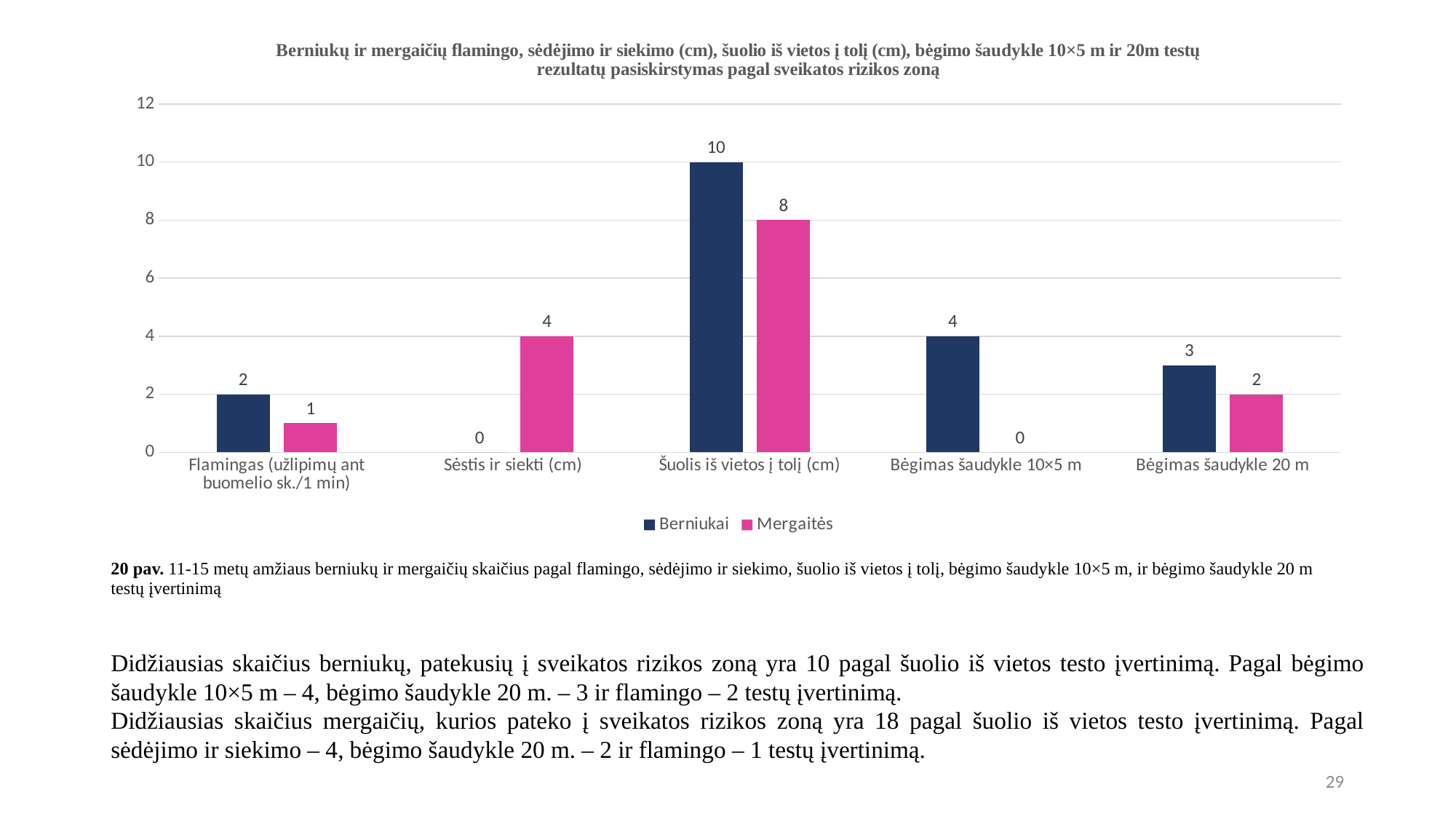
What kind of chart is shown on the slide? Bar chart Which category has the highest value for Mergaitės? Šuolis iš vietos į tolį (cm) What is the value for Mergaitės in the Flamingas (užlipimų ant buomelio sk./1 min) category? 1 What is the difference between Berniukai and Mergaitės in the Šuolis iš vietos į tolį (cm) category? 2 What is the value for Mergaitės in the Sėstis ir siekti (cm) category? 4 How many categories are shown on the x axis? 5 What is the value for Berniukai in the Bėgimas šaudykle 20 m category? 3 How many series does the legend list? 2 What colour are the Mergaitės bars? Pink What is the value for Berniukai in the Šuolis iš vietos į tolį (cm) category? 10 In the Bėgimas šaudykle 10×5 m category, which series has the larger value, Berniukai or Mergaitės? Berniukai Which category has the lowest value for Berniukai? Sėstis ir siekti (cm)